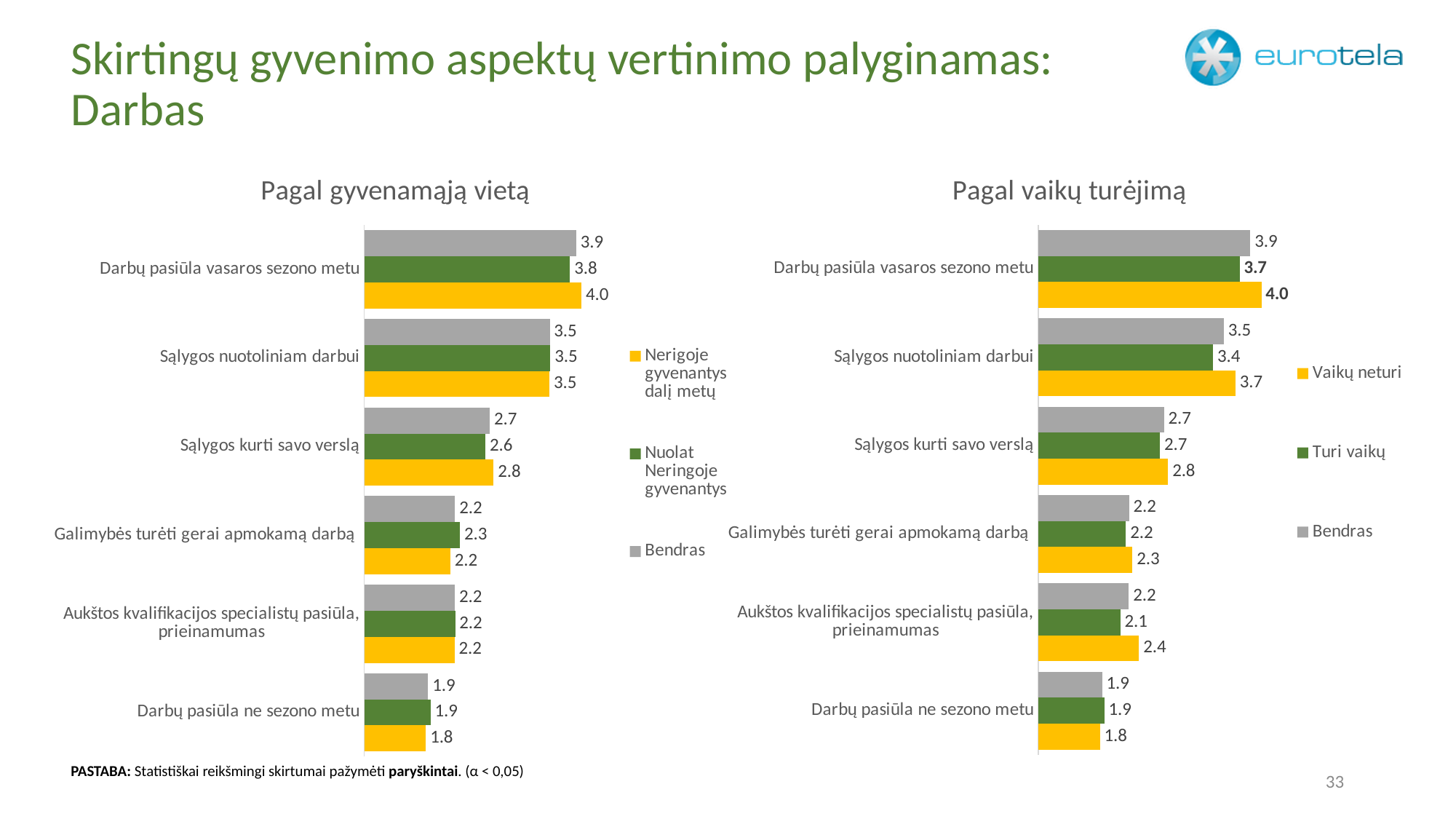
In the 'Pagal vaikų turėjimą' chart, what is the value for 'Vaikų neturi' for 'Aukštos kvalifikacijos specialistų pasiūla, prieinamumas'? 2.4 In the 'Pagal vaikų turėjimą' chart, which category has the highest 'Vaikų neturi' value? Darbų pasiūla vasaros sezono metu In the 'Pagal vaikų turėjimą' chart, what is the difference between the 'Vaikų neturi' and 'Turi vaikų' values for 'Sąlygos nuotoliniam darbui'? 0.3 In the 'Pagal vaikų turėjimą' chart, for 'Aukštos kvalifikacijos specialistų pasiūla, prieinamumas', which is larger: 'Vaikų neturi' or 'Turi vaikų'? Vaikų neturi In the 'Pagal vaikų turėjimą' chart, what is the value for 'Turi vaikų' for 'Sąlygos nuotoliniam darbui'? 3.4 What type of chart is the 'Pagal gyvenamąją vietą' chart? Bar chart In the 'Pagal gyvenamąją vietą' chart, what is the difference between the 'Nerigoje gyvenantys dalį metų' and 'Nuolat Neringoje gyvenantys' values for 'Sąlygos kurti savo verslą'? 0.2 In the 'Pagal gyvenamąją vietą' chart, which colour represents the 'Bendras' series? Grey How many series does the legend of the 'Pagal vaikų turėjimą' chart list? 3 In the 'Pagal gyvenamąją vietą' chart, which category has the lowest 'Bendras' value? Darbų pasiūla ne sezono metu In the 'Pagal gyvenamąją vietą' chart, what is the value for 'Nerigoje gyvenantys dalį metų' for 'Darbų pasiūla vasaros sezono metu'? 4.0 How many categories are shown in the 'Pagal gyvenamąją vietą' chart? 6